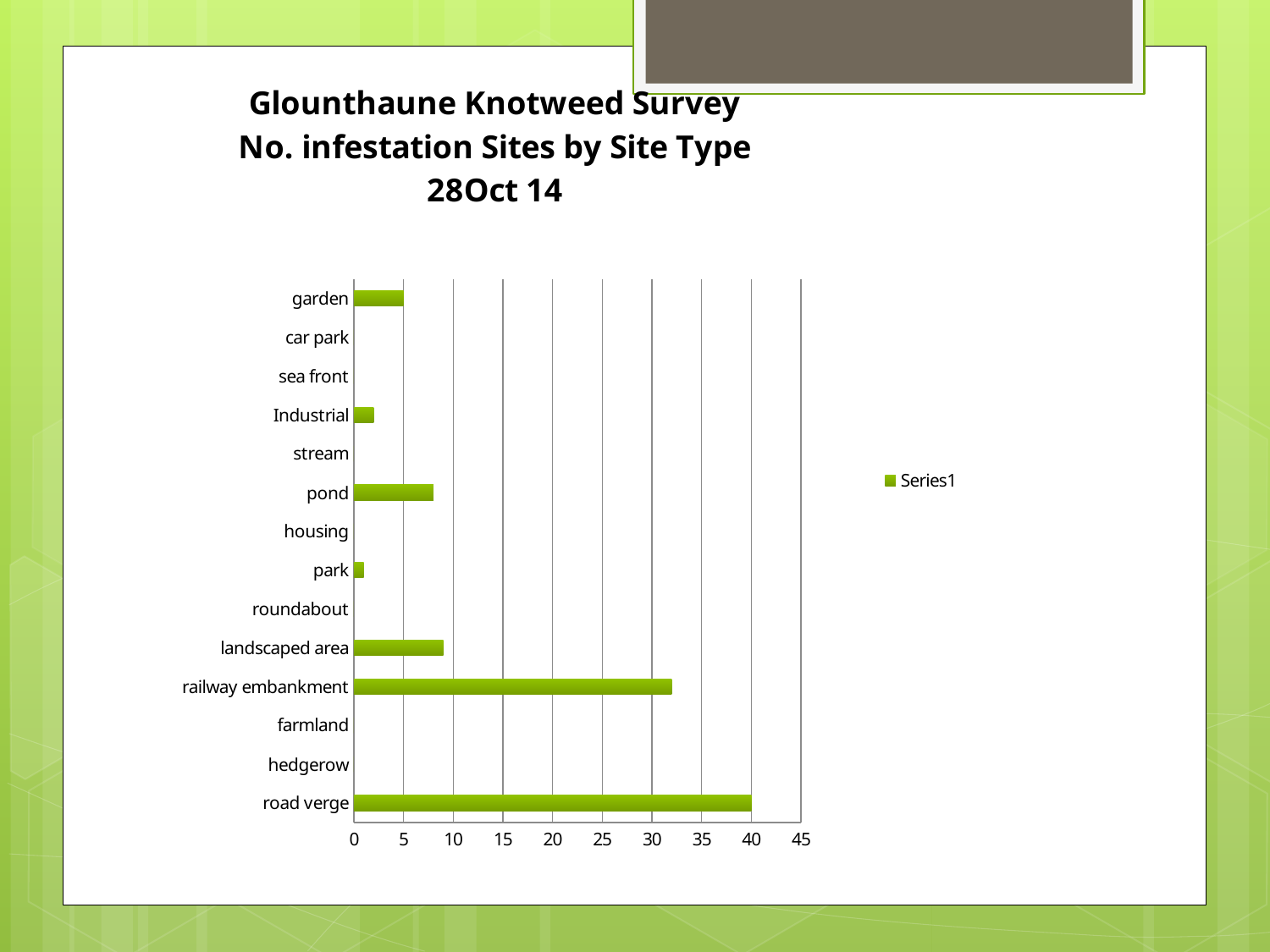
How many series does the legend list? 1 Is the value for railway embankment greater or less than 30? greater Is the value for pond greater or less than 5? greater Is the value for landscaped area greater or less than 10? less What is the value for garden? 5 Which has more infestation sites, railway embankment or landscaped area? railway embankment What kind of chart is shown on the slide? bar chart What is the name of the series shown in the legend? Series1 Which site type has the highest number of infestation sites? road verge How many site type categories are listed on the chart? 14 What is the value for road verge? 40